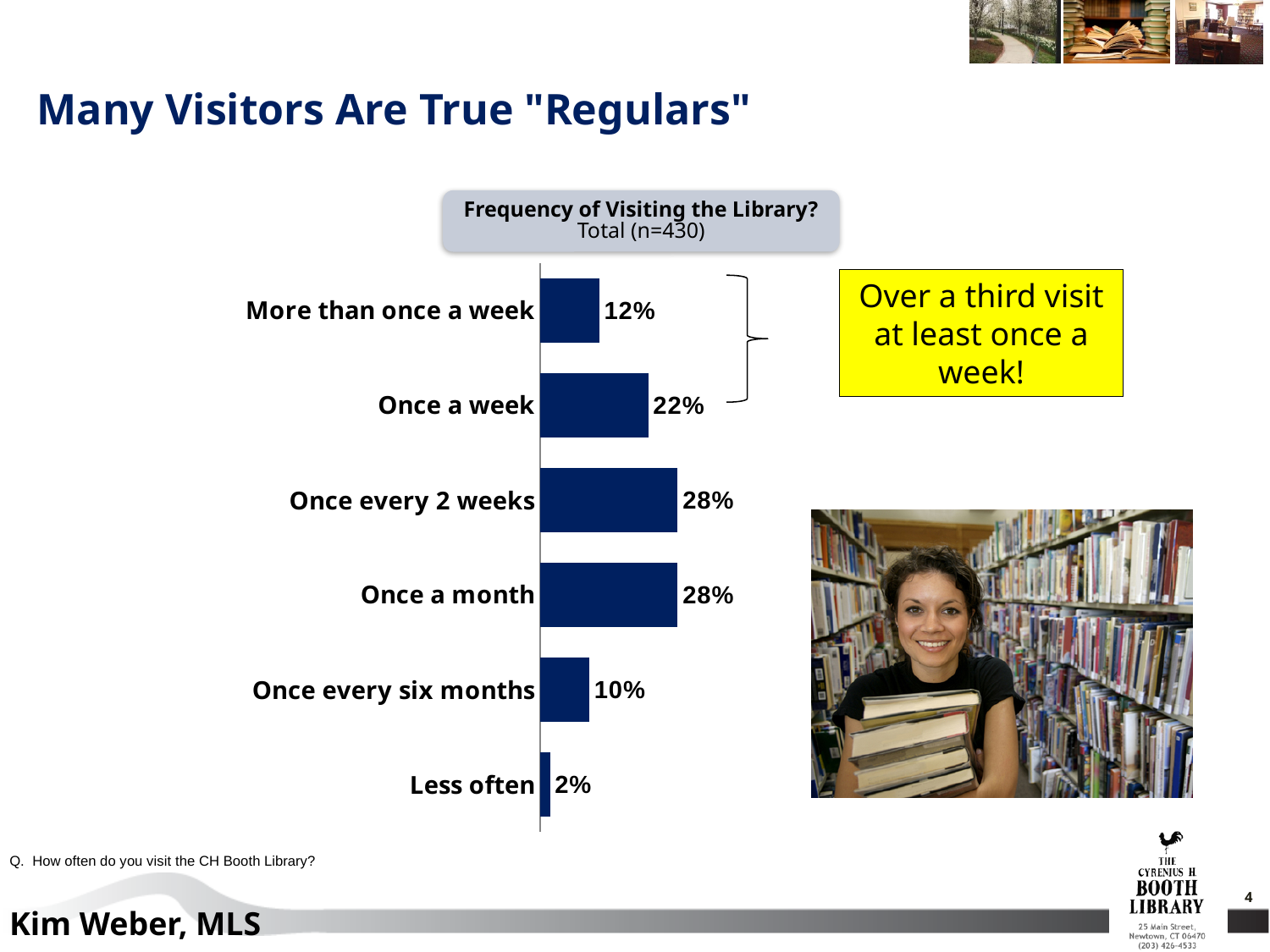
Which is larger: the value for 'Once every 2 weeks' or the value for 'Once every six months'? Once every 2 weeks What type of chart is shown on the slide? Bar chart What percentage of respondents visit the library more than once a week? 12% What is the difference in percentage points between 'Once a week' and 'More than once a week'? 10 What is the combined percentage of respondents who visit at least once a week (more than once a week plus once a week)? 34% What is the sample size (n) shown in the chart title? 430 How many categories are shown in the chart? 6 What percentage of respondents visit the library once every six months? 10% What percentage of respondents visit the library once a week? 22% What percentage of respondents visit the library less often than once every six months? 2% What is the title of the chart? Frequency of Visiting the Library? Which category has the lowest percentage? Less often